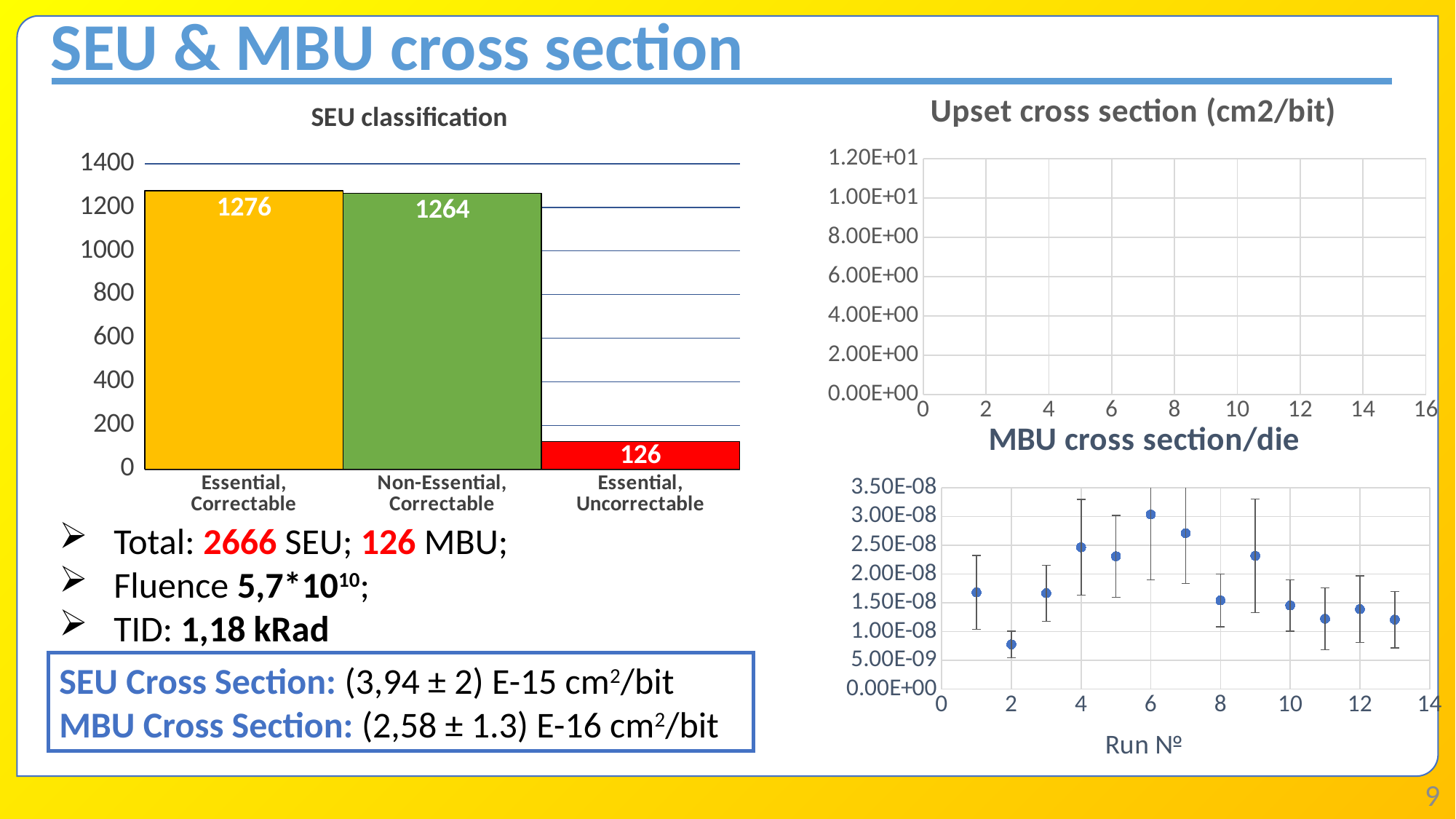
In the MBU cross section/die chart, how many data points are plotted? 13 In the SEU classification chart, what is the value for Non-Essential, Correctable? 1264 In the SEU classification chart, what is the difference between Essential, Correctable and Non-Essential, Correctable? 12 In the SEU classification chart, which category has the highest value? Essential, Correctable What kind of chart is the SEU classification chart? bar chart In the SEU classification chart, how many categories are shown? 3 In the MBU cross section/die chart, which run number has the highest value? 6 In the SEU classification chart, which category has the lowest value? Essential, Uncorrectable In the SEU classification chart, what is the value for Essential, Correctable? 1276 What is the x-axis title of the MBU cross section/die chart? Run № In the SEU classification chart, what is the value for Essential, Uncorrectable? 126 In the MBU cross section/die chart, is the value for run 2 greater or less than 1.00E-08? less